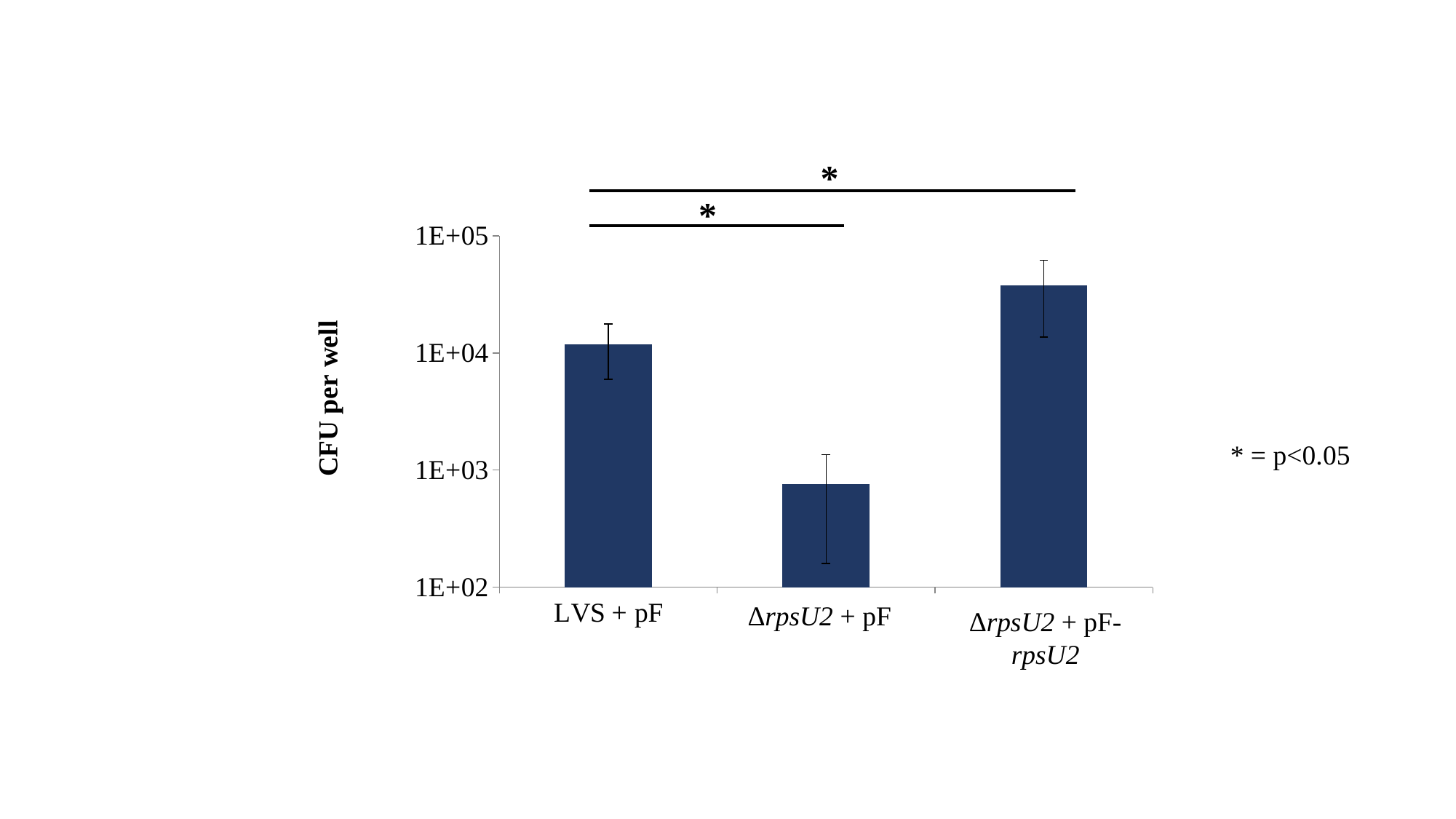
Which category has the highest CFU per well? ΔrpsU2 + pF-rpsU2 Which has the larger CFU per well, LVS + pF or ΔrpsU2 + pF? LVS + pF What does the asterisk on the chart indicate, according to the note on the slide? p<0.05 Which category has the lowest CFU per well? ΔrpsU2 + pF Which has the larger CFU per well, ΔrpsU2 + pF-rpsU2 or ΔrpsU2 + pF? ΔrpsU2 + pF-rpsU2 Is the value for ΔrpsU2 + pF-rpsU2 greater or less than 1E+05? less What kind of chart is shown on the slide? bar chart How many categories are plotted on the x axis? 3 Is the value for LVS + pF greater or less than 1E+05? less What is the label of the y axis? CFU per well Is the value for ΔrpsU2 + pF greater or less than 1E+03? less